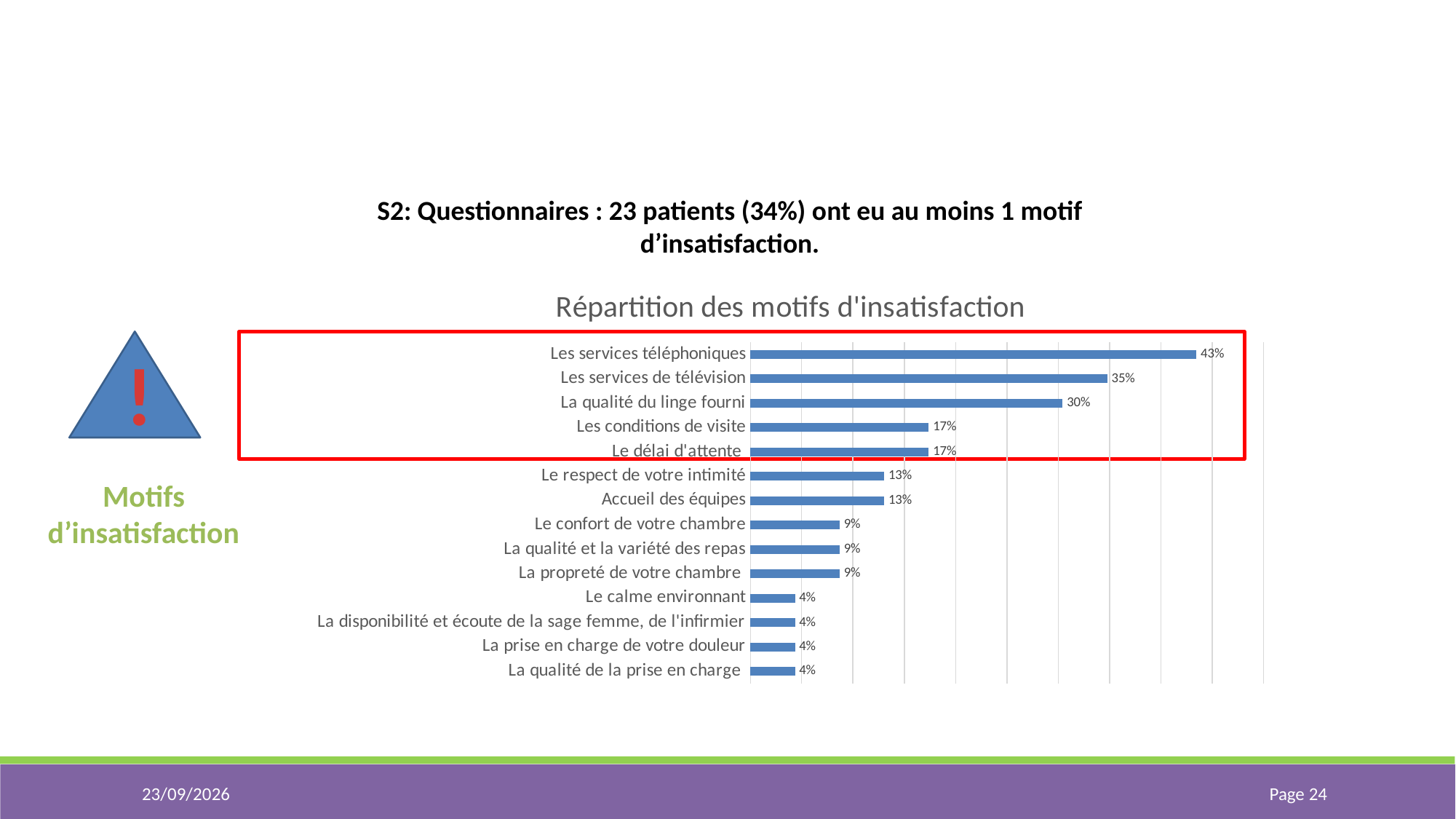
How many categories have a value of 4%? 4 Which category has the highest value? Les services téléphoniques What is the title of the chart? Répartition des motifs d'insatisfaction What is the value for "Le respect de votre intimité"? 13% Which is larger, the value for "Les services de télévision" or the value for "Accueil des équipes"? Les services de télévision How many categories are shown in the chart? 14 What is the value for "Les services téléphoniques"? 43% What is the value for "Le calme environnant"? 4% What kind of chart is shown on the slide? Bar chart What is the value for "La qualité du linge fourni"? 30% What is the difference between the values for "La qualité du linge fourni" and "Les conditions de visite"? 13% What is the difference between the values for "Les services téléphoniques" and "Les services de télévision"? 8%